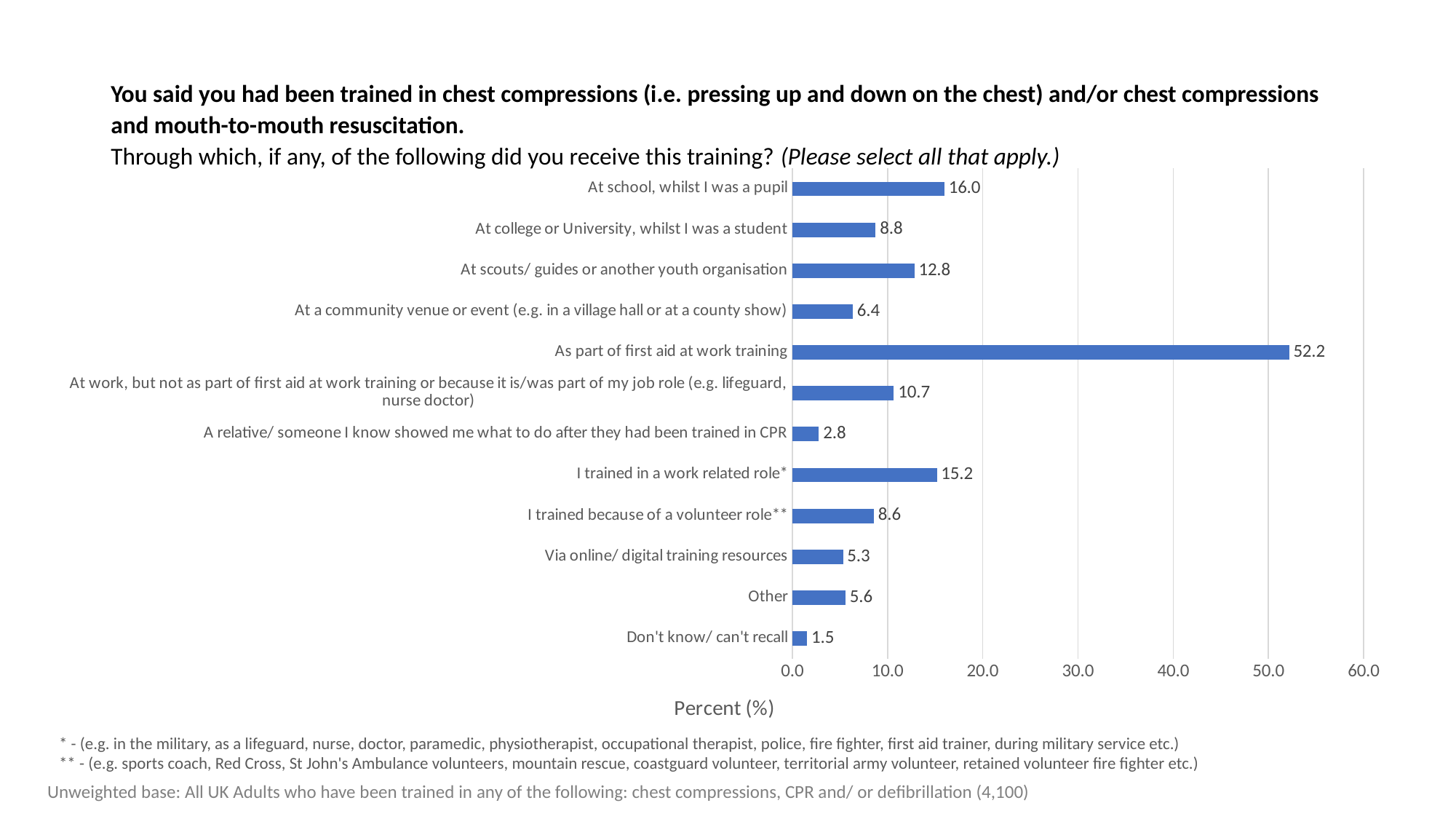
What is the value for 'As part of first aid at work training'? 52.2 What is the value for 'At school, whilst I was a pupil'? 16.0 Which is larger: 'At scouts/ guides or another youth organisation' or 'I trained in a work related role*'? I trained in a work related role* Is the value for 'As part of first aid at work training' greater or less than 50.0? greater How many categories are shown in the chart? 12 What is the value for 'A relative/ someone I know showed me what to do after they had been trained in CPR'? 2.8 What is the value for 'Via online/ digital training resources'? 5.3 Which category has the lowest value? Don't know/ can't recall Which category has the highest value? As part of first aid at work training What is the label of the horizontal axis? Percent (%) What kind of chart is shown on the slide? bar chart What is the difference between 'At school, whilst I was a pupil' and 'At college or University, whilst I was a student'? 7.2